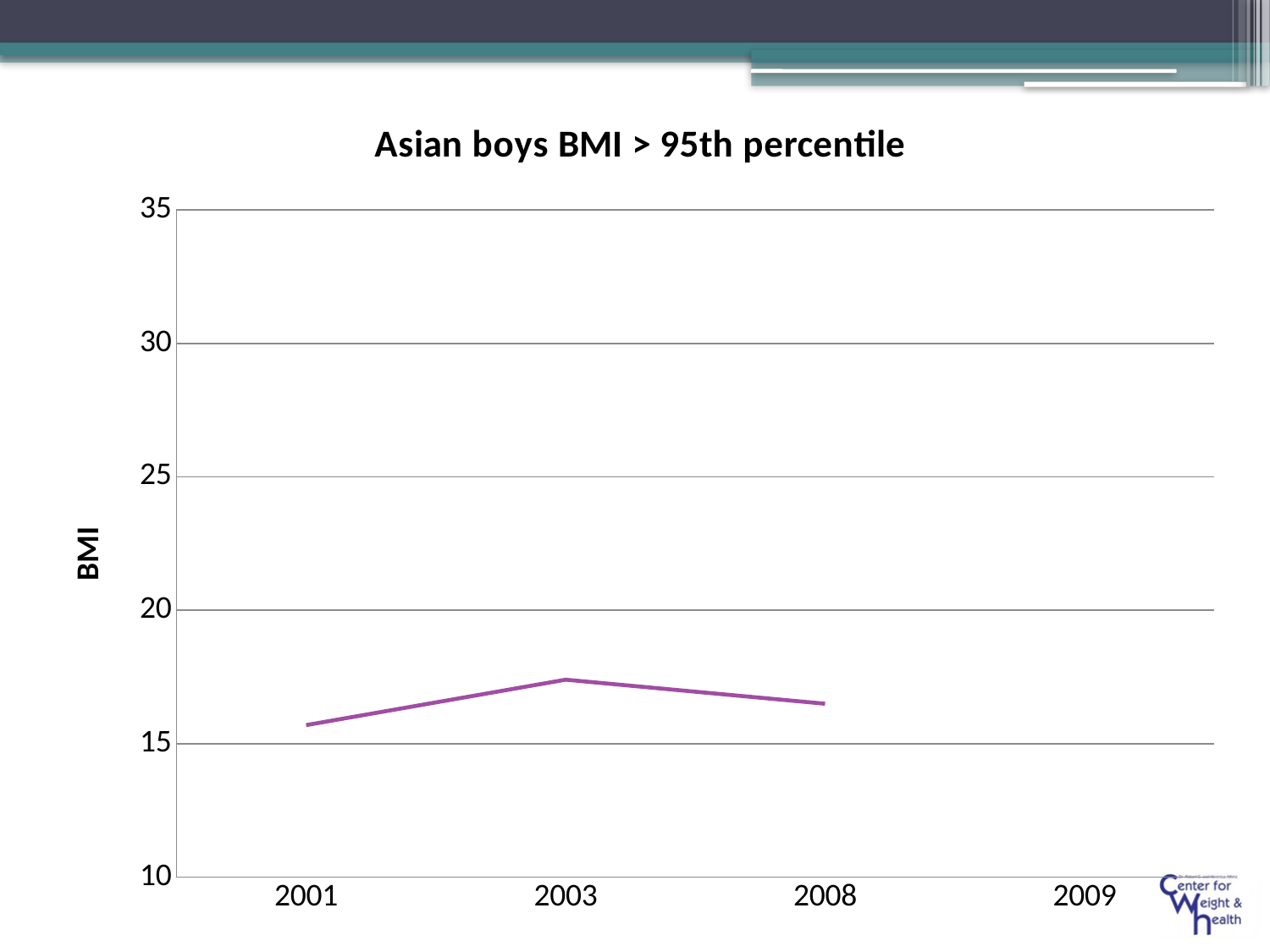
In which year is the plotted BMI value highest? 2003 Is the BMI value for 2008 greater or less than 20? less What is the title of the chart? Asian boys BMI > 95th percentile Is the BMI value for 2001 greater or less than 15? greater Which year has the larger BMI value, 2001 or 2008? 2008 Does the BMI value rise or fall from 2003 to 2008? fall Is the BMI value for 2003 greater or less than 20? less How many years are labelled on the x axis of the chart? 4 Which year has the larger BMI value, 2003 or 2008? 2003 What is the label on the vertical axis of the chart? BMI In which year is the plotted BMI value lowest? 2001 What kind of chart is shown on the slide? line chart